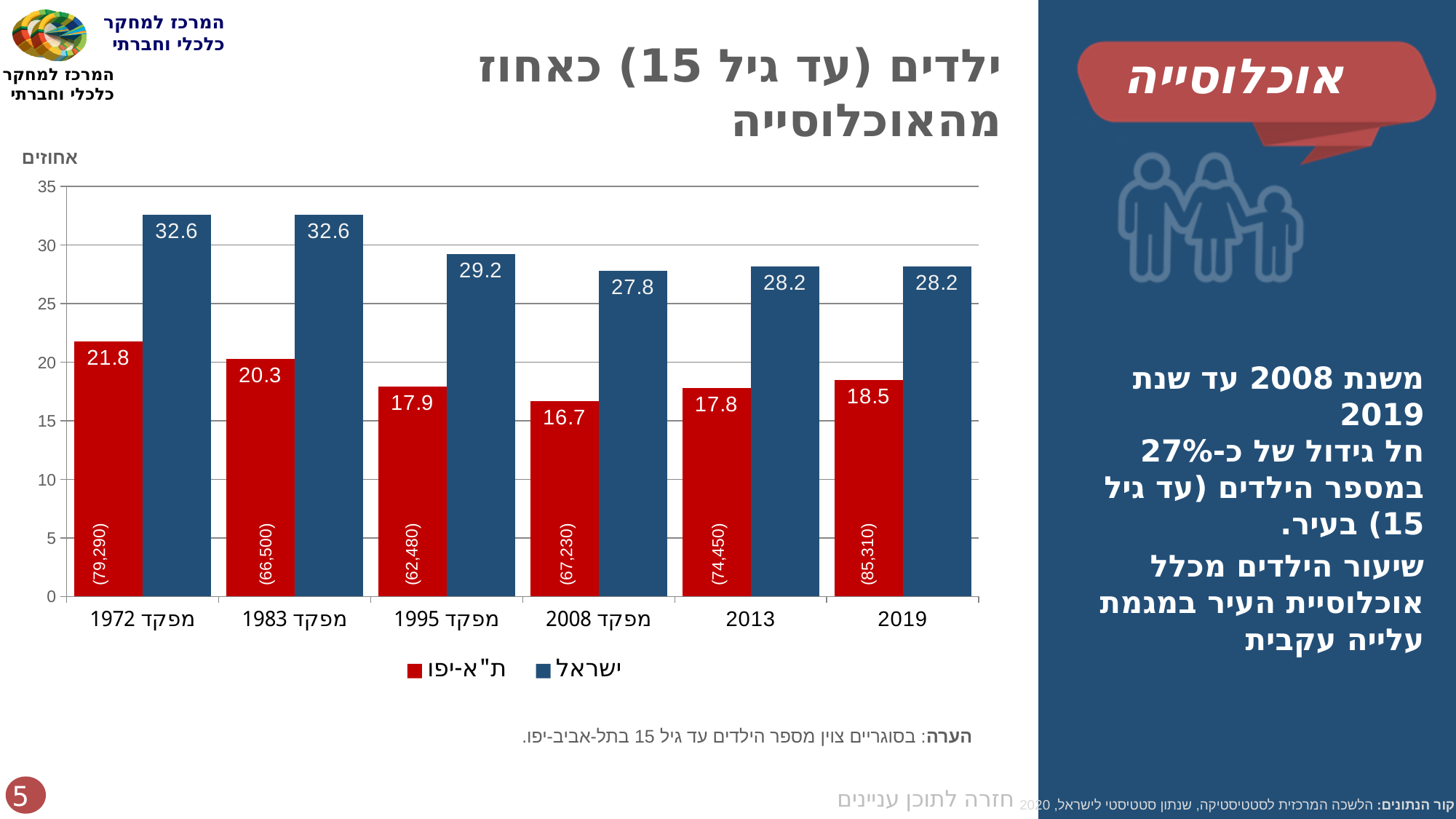
What is the difference between the ישראל and ת"א-יפו values in מפקד 1995? 11.3 What is the value for ת"א-יפו in מפקד 1972? 21.8 What number of children in Tel Aviv-Yafo is shown in parentheses for 2013? (74,450) In which category is the ת"א-יפו value highest? מפקד 1972 In which category is the ת"א-יפו value lowest? מפקד 2008 What is the value for ת"א-יפו in 2019? 18.5 Which is larger in 2013: the value for ישראל or for ת"א-יפו? ישראל How many series does the legend list? 2 What is the value for ישראל in מפקד 2008? 27.8 Does the ישראל value rise or fall from מפקד 1983 to מפקד 2008? fall How many categories are shown on the x axis? 6 What kind of chart is shown on the slide? bar chart